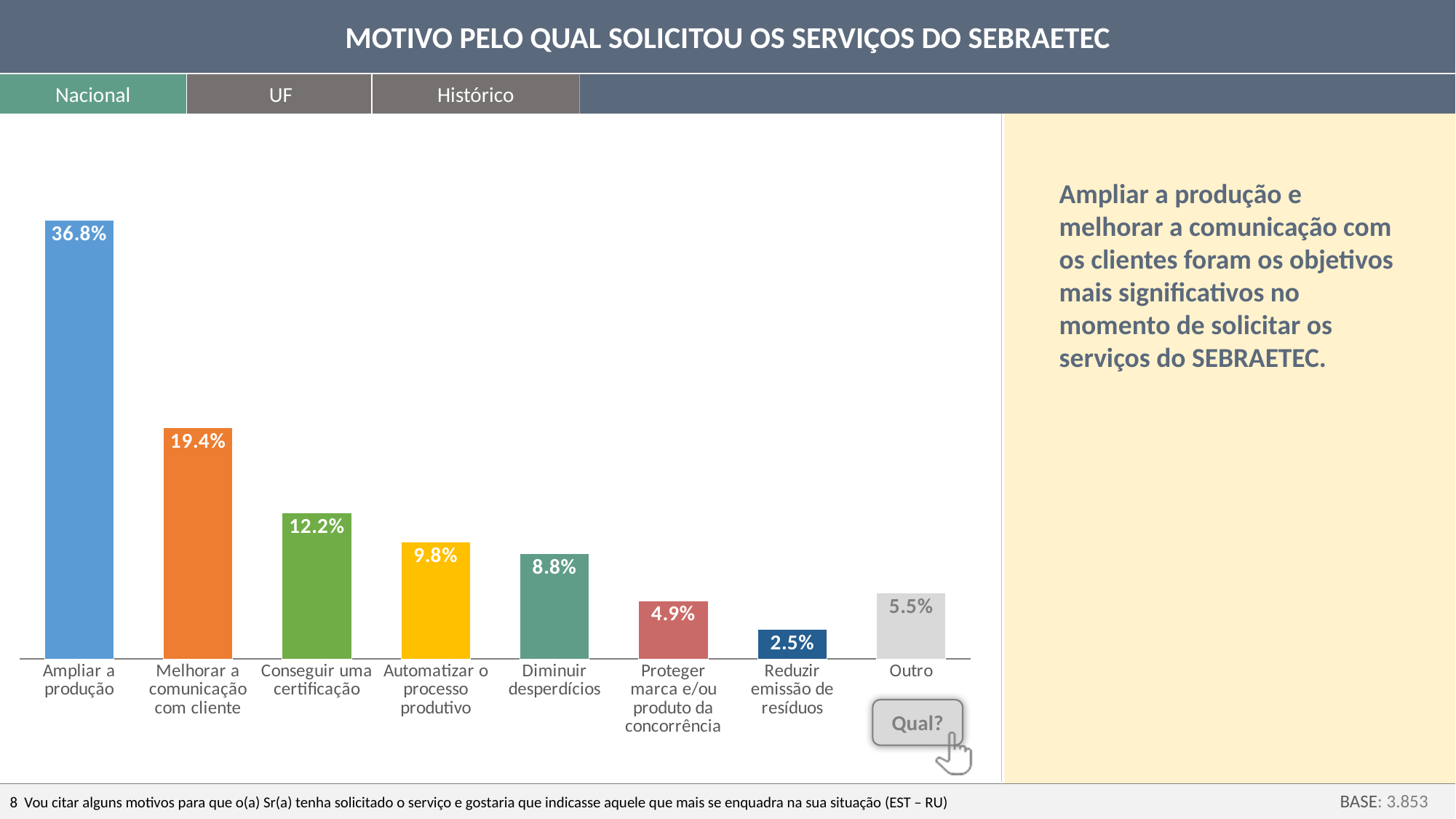
Which is larger: 'Automatizar o processo produtivo' or 'Diminuir desperdícios'? Automatizar o processo produtivo How many categories are shown in the chart? 8 What is the difference between 'Ampliar a produção' and 'Melhorar a comunicação com cliente'? 17.4% What is the value for 'Ampliar a produção'? 36.8% Which category has the lowest value? Reduzir emissão de resíduos What is the value for 'Melhorar a comunicação com cliente'? 19.4% What is the value for 'Conseguir uma certificação'? 12.2% Which category has the highest value? Ampliar a produção What is the value for 'Outro'? 5.5% What is the title of the slide? MOTIVO PELO QUAL SOLICITOU OS SERVIÇOS DO SEBRAETEC What kind of chart is shown on the slide? Bar chart What is the value for 'Reduzir emissão de resíduos'? 2.5%